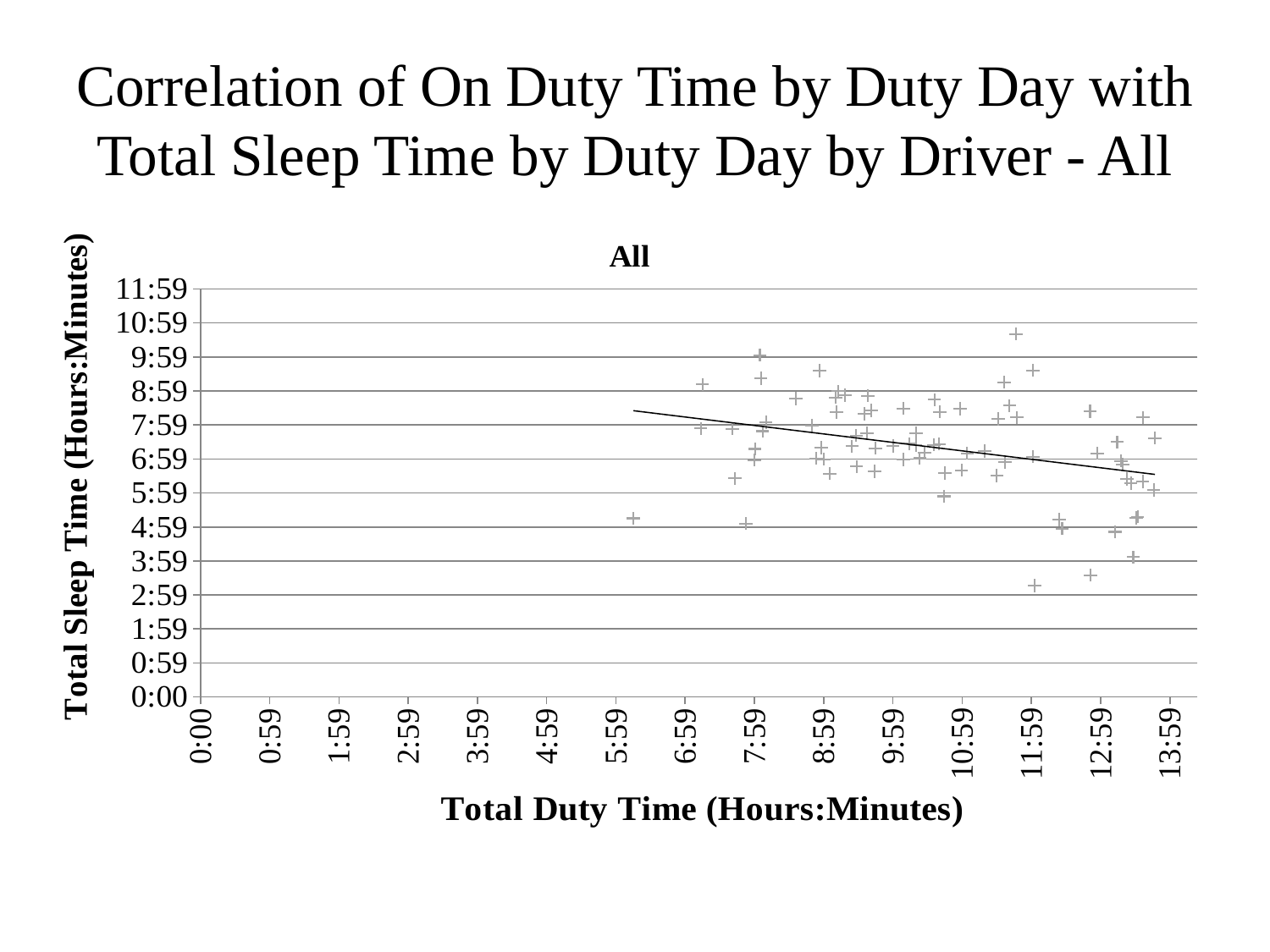
What is the x-axis title of the chart? Total Duty Time (Hours:Minutes) Is the smallest plotted Total Duty Time value greater or less than 4:59? greater Is the lowest plotted Total Sleep Time value greater or less than 3:59? less Does the trend line fall or rise as Total Duty Time increases along the x axis? falls At its left-hand end, is the trend line's Total Sleep Time value greater or less than 6:59? greater What is the title printed above the plot area of the chart? All What kind of chart is shown on the slide? scatter chart